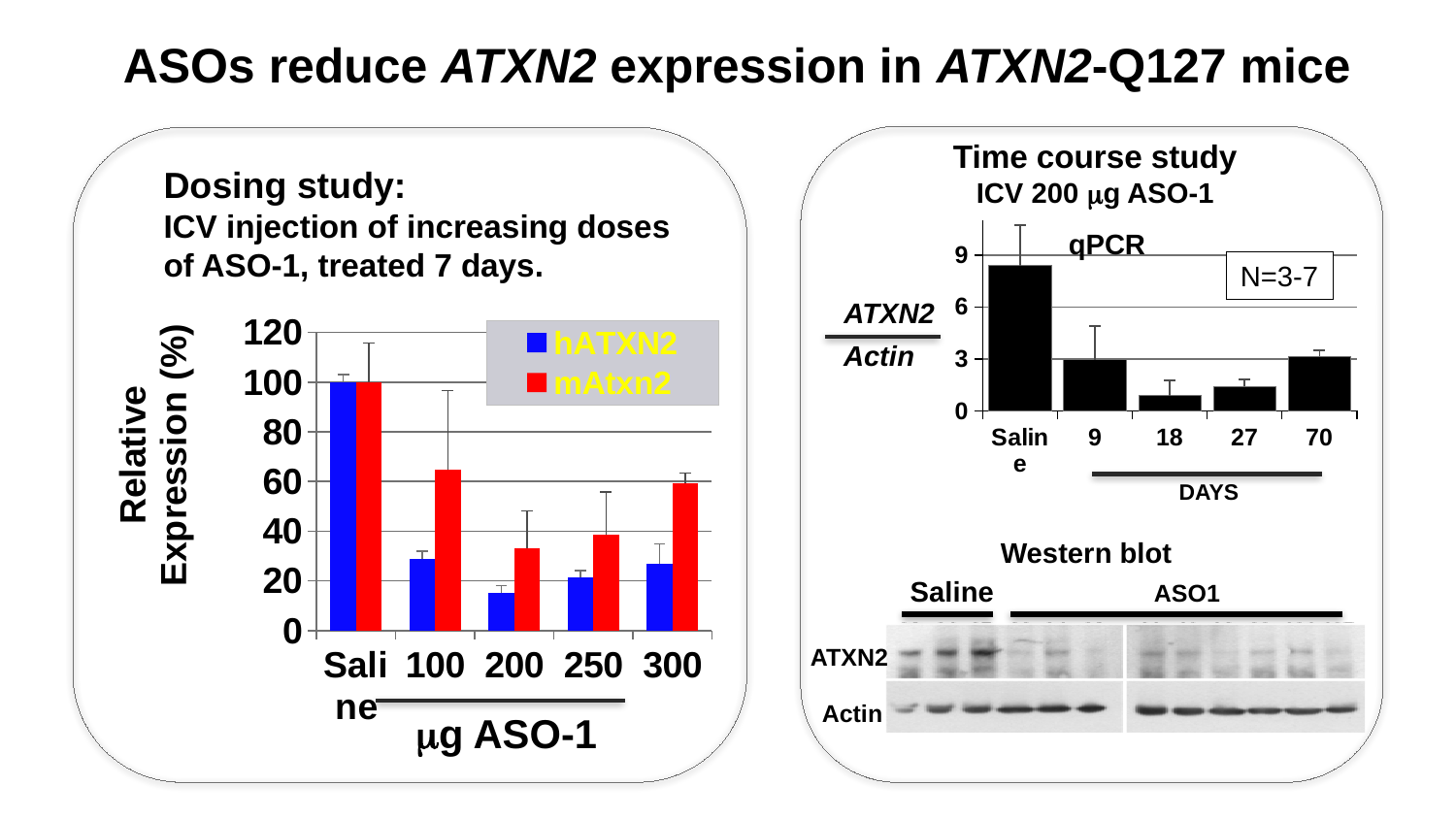
In the Dosing study chart, what is the relative expression of hATXN2 for Saline? 100 In the Time course study chart, is the value at 18 days greater or less than 3? less How many categories are shown on the x axis of the Time course study chart? 5 How many dose categories are shown on the x axis of the Dosing study chart? 5 In the Dosing study chart, what colour represents mAtxn2 in the legend? red How many series does the legend of the Dosing study chart list? 2 In the Time course study chart, which category has the highest ATXN2/Actin value? Saline In the Dosing study chart, is the hATXN2 value at 200 µg greater or less than 20? less What kind of chart is the Dosing study chart on the left? bar chart In the Dosing study chart, is the mAtxn2 value at 300 µg greater or less than 40? greater In the Dosing study chart, which dose has the lowest hATXN2 relative expression? 200 In the Dosing study chart, at 100 µg ASO-1, which is larger: hATXN2 or mAtxn2? mAtxn2